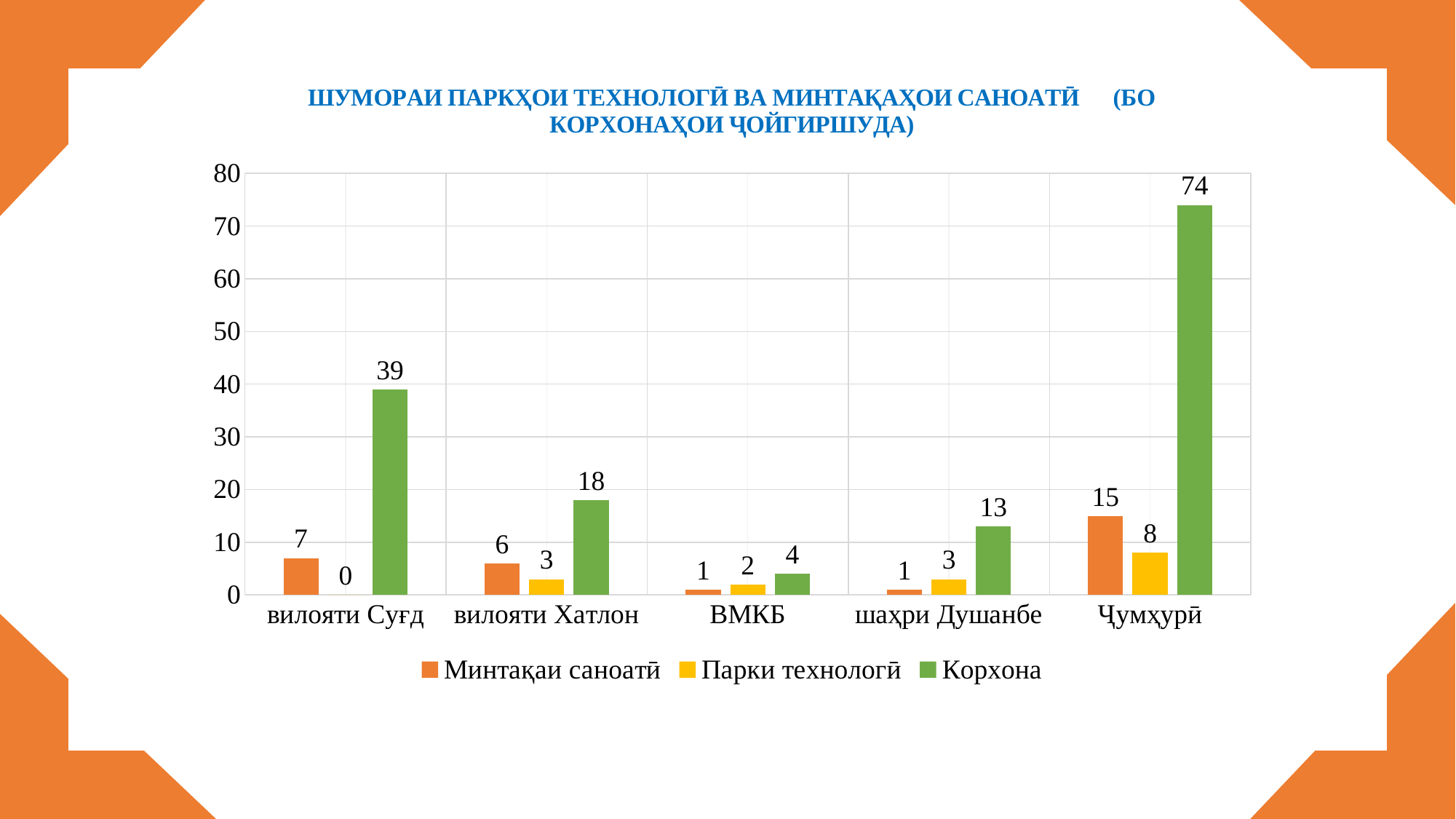
What is the value of Парки технологӣ for вилояти Суғд? 0 What kind of chart is shown on the slide? bar chart Is the Корхона value for Ҷумҳурӣ greater or less than 70? greater Which is larger: Минтақаи саноатӣ for вилояти Суғд or Минтақаи саноатӣ for вилояти Хатлон? вилояти Суғд How many categories are shown on the x axis? 5 Which category has the highest Корхона value? Ҷумҳурӣ What is the value of Минтақаи саноатӣ for Ҷумҳурӣ? 15 How many series does the legend list? 3 What is the value of Корхона for вилояти Суғд? 39 Which category has the lowest Корхона value? ВМКБ What is the value of Парки технологӣ for вилояти Хатлон? 3 What is the difference between the Корхона values for Ҷумҳурӣ and вилояти Суғд? 35